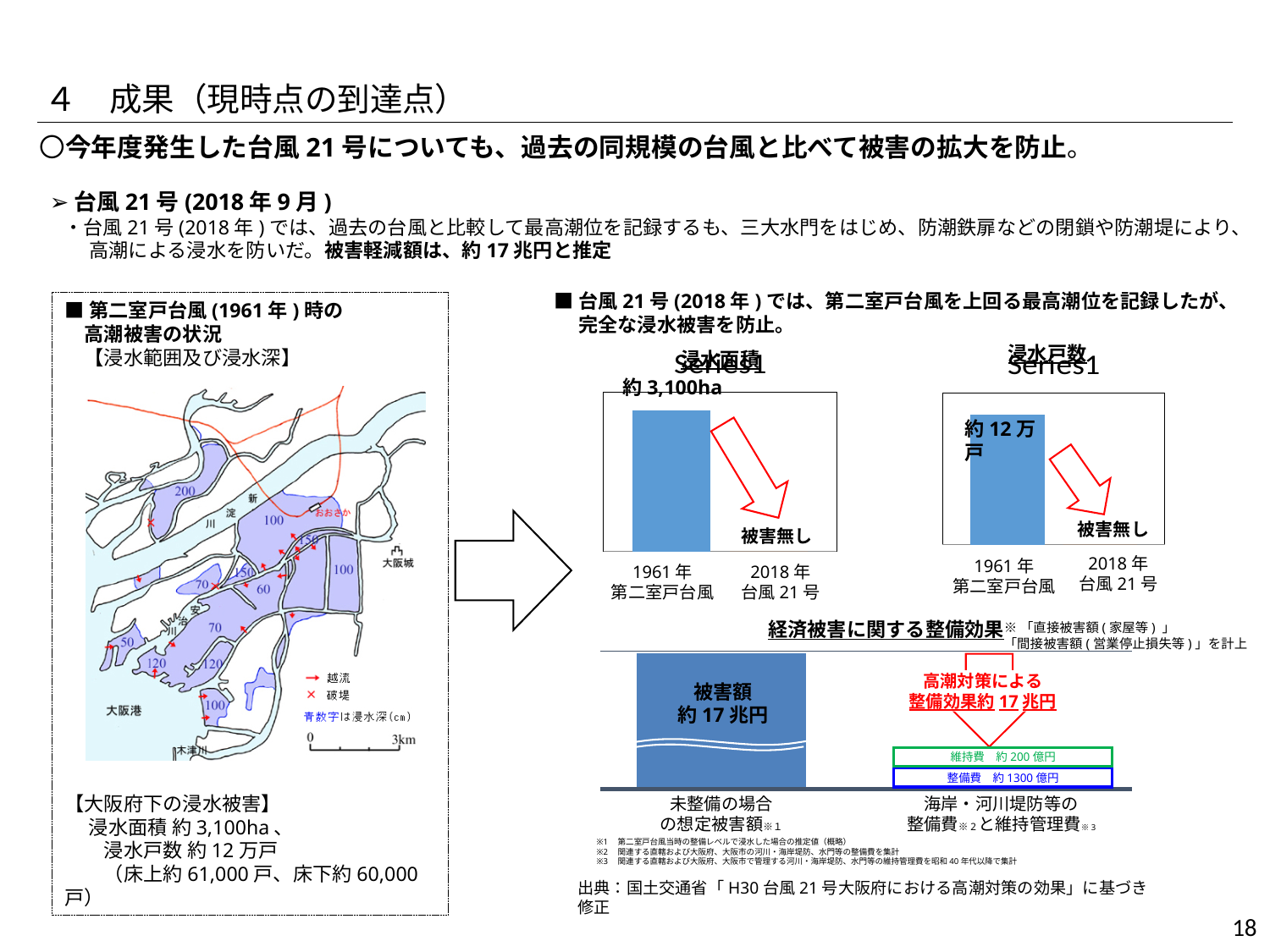
In the 浸水戸数 chart, what value is shown for 1961年 第二室戸台風? 約12万戸 In the 浸水面積 chart, what is shown for 2018年 台風21号? 被害無し What colour is the bar for 1961年 第二室戸台風 in the 浸水戸数 chart? blue In the 経済被害に関する整備効果 figure, what is the 被害額 shown for 未整備の場合の想定被害額? 約17兆円 In the 浸水戸数 chart, which category has the higher value, 1961年 第二室戸台風 or 2018年 台風21号? 1961年 第二室戸台風 What series name is displayed above the 浸水面積 and 浸水戸数 charts? Series1 In the 浸水戸数 chart, what is shown for 2018年 台風21号? 被害無し How many categories are on the x axis of the 浸水面積 chart? 2 In the 経済被害に関する整備効果 figure, what is the 整備費 value shown? 約1300億円 In the 浸水面積 chart, which category has the highest value? 1961年 第二室戸台風 What kind of chart is the 浸水面積 chart on the right side of the slide? bar chart In the 浸水面積 chart, what value is shown for 1961年 第二室戸台風? 約3,100ha